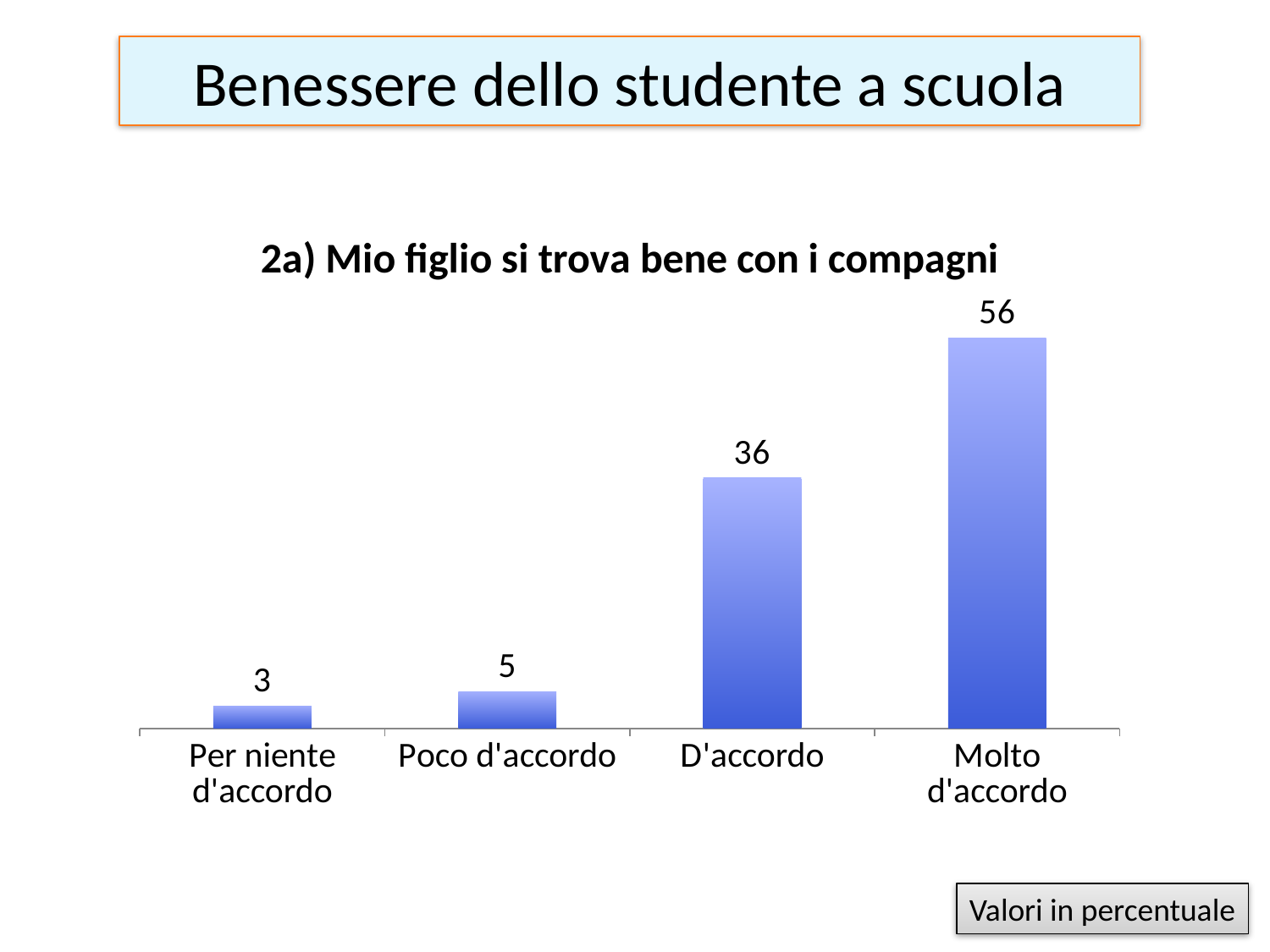
Which category has the lowest value? Per niente d'accordo What is the difference between the values for "Molto d'accordo" and "D'accordo"? 20 What is the value for "Molto d'accordo"? 56 What is the value for "D'accordo"? 36 How many categories are shown on the x axis? 4 What is the value for "Per niente d'accordo"? 3 What is the value for "Poco d'accordo"? 5 Which is larger, the value for "D'accordo" or the value for "Poco d'accordo"? D'accordo Which category has the highest value? Molto d'accordo What kind of chart is shown on the slide? Bar chart What is the title of the chart? 2a) Mio figlio si trova bene con i compagni What is the difference between the values for "Poco d'accordo" and "Per niente d'accordo"? 2